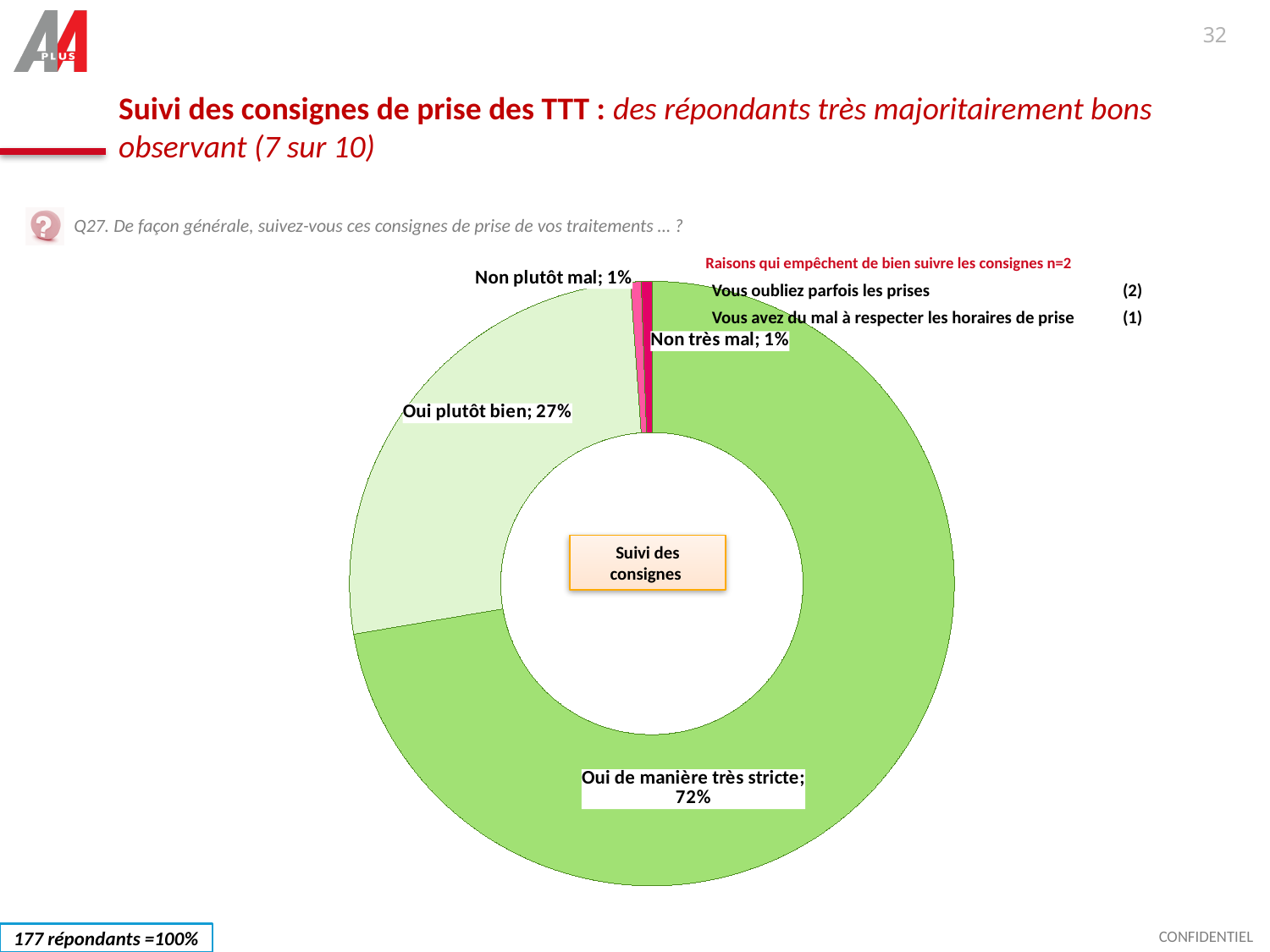
How many categories (slices) does the chart show? 4 What percentage of respondents answered "Oui de manière très stricte"? 72% What kind of chart is shown on the slide? Doughnut (pie) chart What label is shown in the centre of the doughnut chart? Suivi des consignes Which is larger: the share for "Oui plutôt bien" or the share for "Non plutôt mal"? Oui plutôt bien Which category has the largest share of the chart? Oui de manière très stricte What percentage of respondents answered "Non très mal"? 1% What is the difference in percentage points between "Oui de manière très stricte" and "Oui plutôt bien"? 45 percentage points What is the combined share of the two "Oui" categories ("Oui de manière très stricte" and "Oui plutôt bien")? 99% How many respondents make up 100% of the chart, according to the note at the bottom of the slide? 177 répondants What percentage of respondents answered "Non plutôt mal"? 1% What percentage of respondents answered "Oui plutôt bien"? 27%